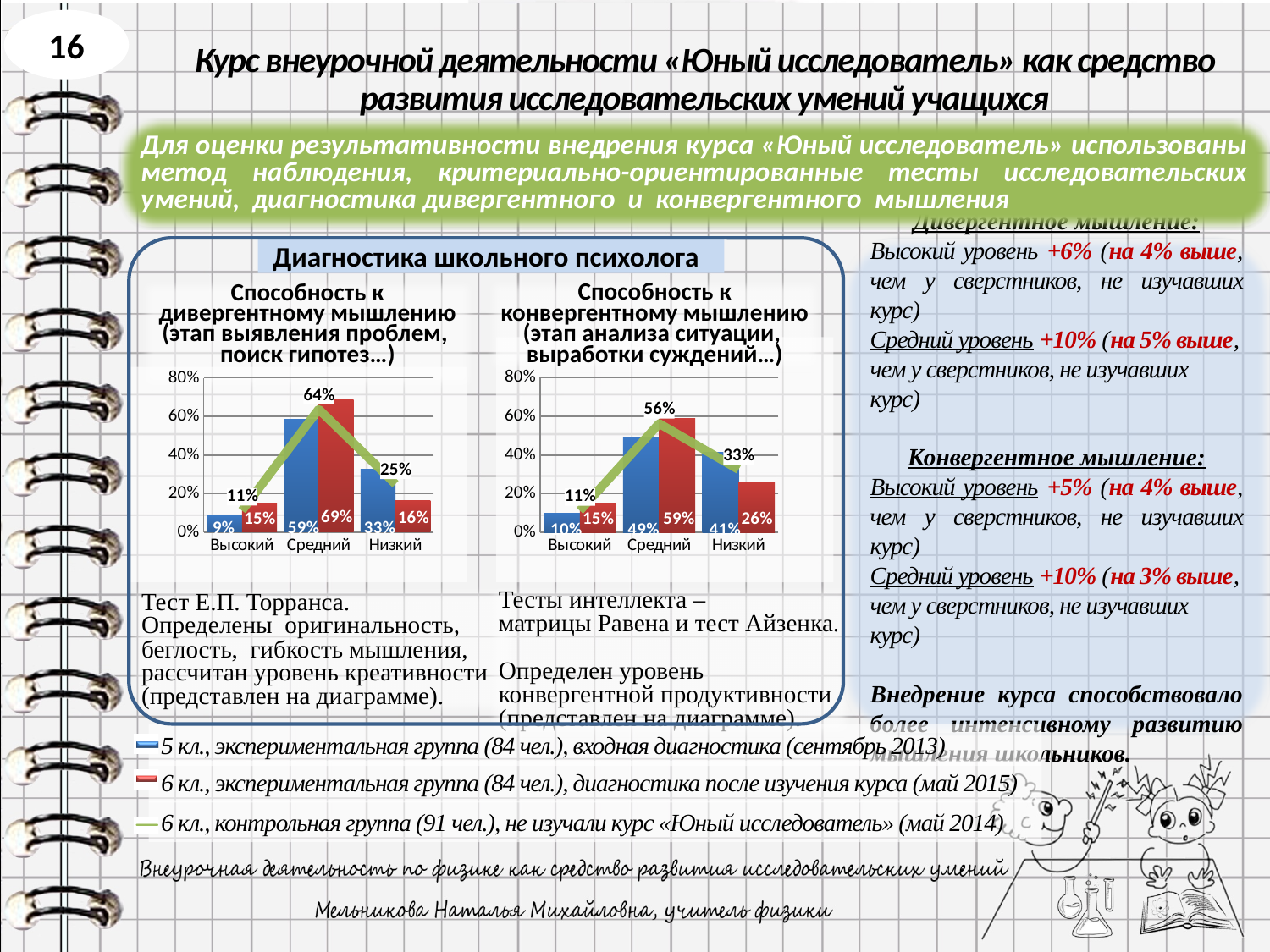
How many categories are shown on the x axis of the chart 'Способность к конвергентному мышлению'? 3 In the chart 'Способность к конвергентному мышлению', which category has the lowest value for the blue bar series? Высокий In the chart 'Способность к дивергентному мышлению', what is the difference between the red bar and the blue bar for the 'Средний' category? 10% In the chart 'Способность к дивергентному мышлению', what is the value of the red bar (6 кл., экспериментальная группа, после изучения курса) for the 'Средний' category? 69% In the chart 'Способность к дивергентному мышлению', which category has the highest value for the red bar series? Средний In the chart 'Способность к дивергентному мышлению', what is the value of the blue bar (5 кл., входная диагностика) for the 'Низкий' category? 33% What type of chart is 'Способность к дивергентному мышлению'? bar chart with a line series In the chart 'Способность к конвергентному мышлению', what is the difference between the blue bar and the red bar for the 'Низкий' category? 15% In the chart 'Способность к конвергентному мышлению', what is the value of the red bar for the 'Низкий' category? 26% In the chart 'Способность к конвергентному мышлению', what is the value of the green line (контрольная группа) for the 'Средний' category? 56% In the chart 'Способность к дивергентному мышлению', which is larger for the 'Низкий' category: the blue bar or the red bar? the blue bar How many series does the legend at the bottom of the slide list for the charts? 3